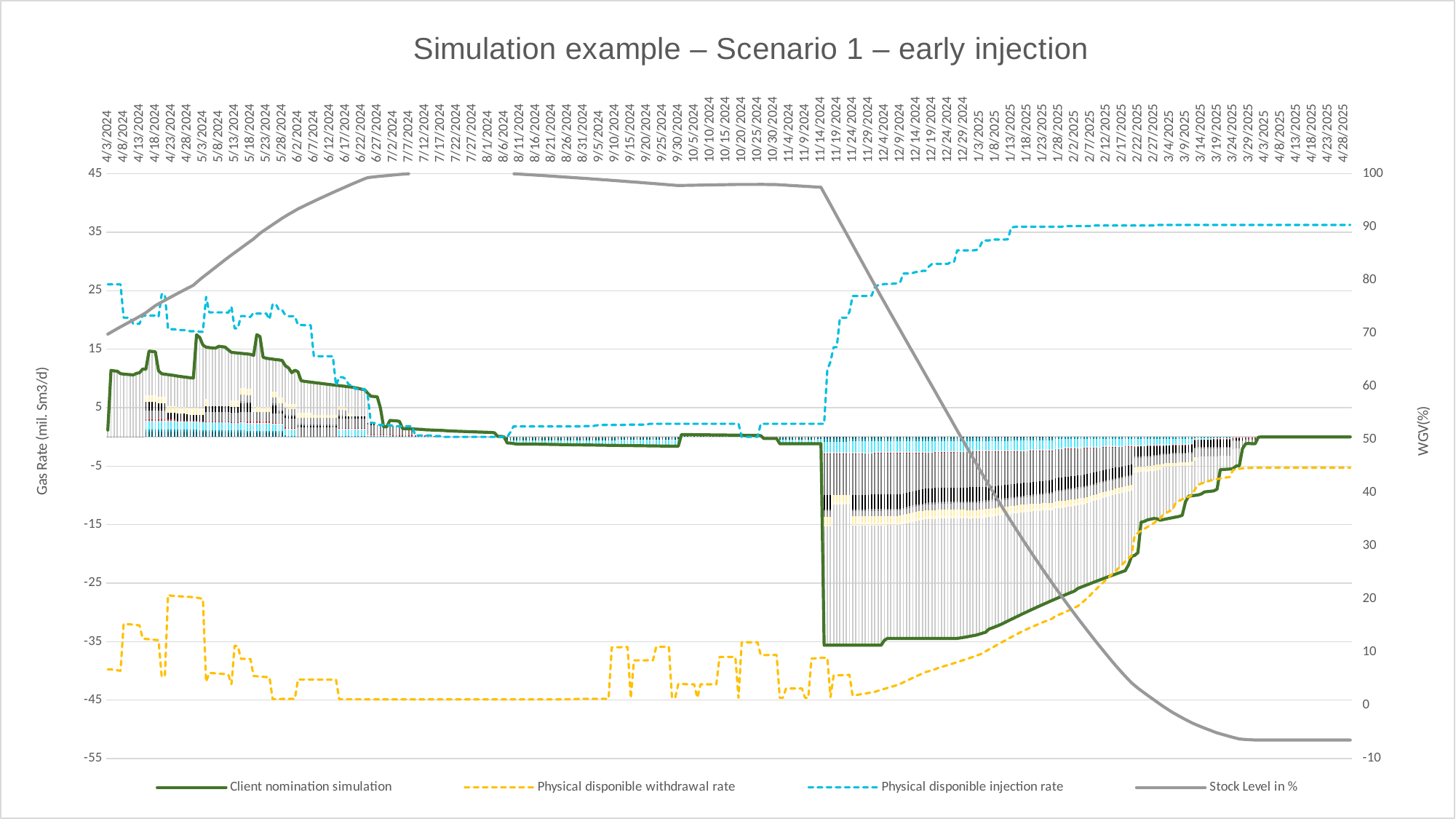
Is the value of Client nomination simulation on 5/3/2024 greater or less than 10? greater Does Stock Level in % rise or fall between 11/14/2024 and 4/3/2025? fall What kind of chart is this? combination chart with stacked bars and lines Is the value of Stock Level in % on 4/28/2025 greater or less than 0? less What is the label of the left vertical axis? Gas Rate (mil. Sm3/d) Which is higher for Stock Level in %: the value on 4/3/2024 or the value on 4/28/2025? 4/3/2024 Is the value of Stock Level in % on 4/3/2024 greater or less than 60? greater How many series does the chart legend list? 4 Does Stock Level in % rise or fall between 4/3/2024 and 7/7/2024? rise What is the title of the chart? Simulation example – Scenario 1 – early injection